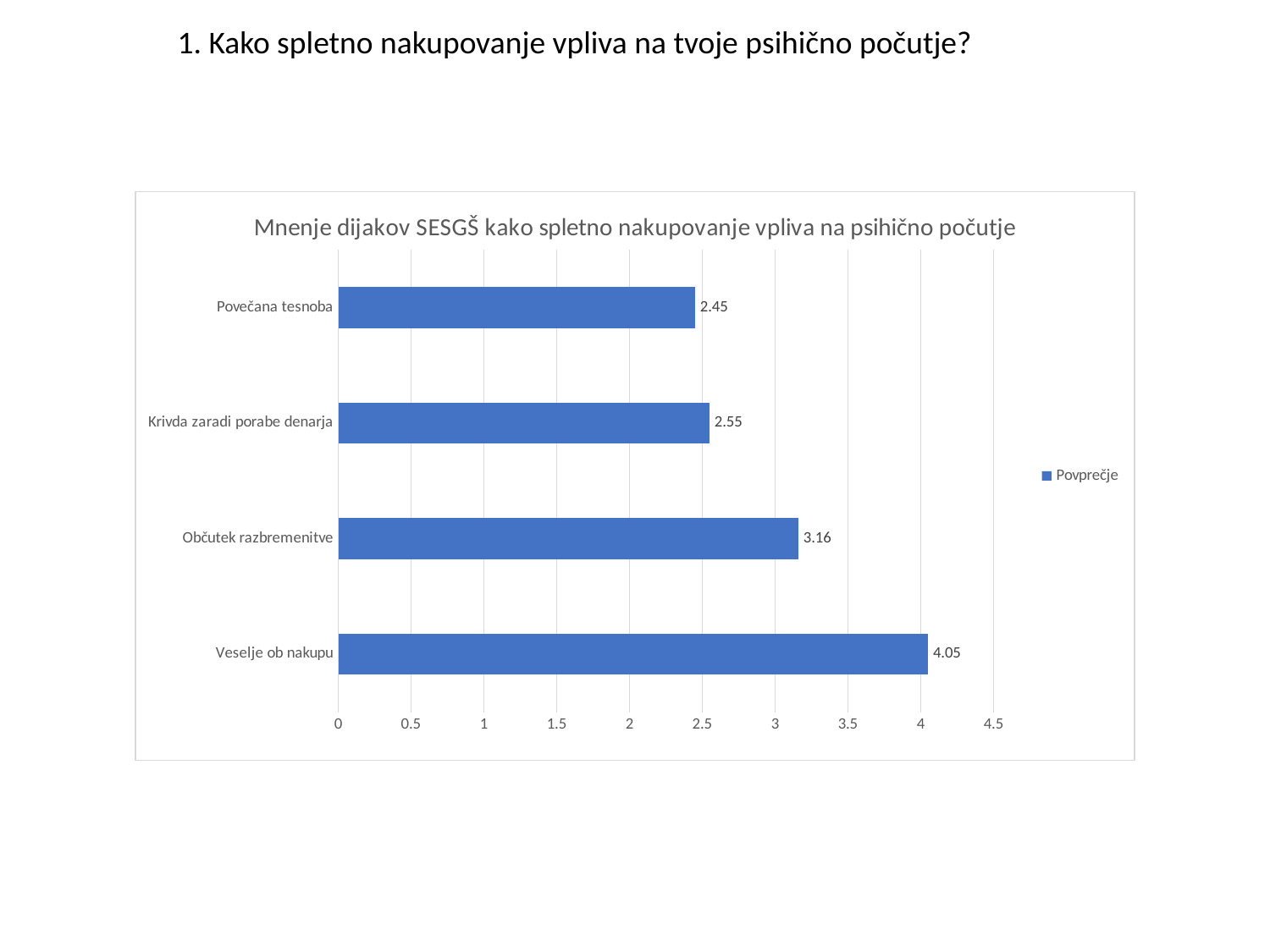
What is the value for Krivda zaradi porabe denarja? 2.55 How many categories are shown in the chart? 4 What is the value for Veselje ob nakupu? 4.05 What is the difference between the values for Krivda zaradi porabe denarja and Povečana tesnoba? 0.1 What series name does the legend list? Povprečje What is the difference between the values for Veselje ob nakupu and Občutek razbremenitve? 0.89 Which is larger, the value for Občutek razbremenitve or the value for Krivda zaradi porabe denarja? Občutek razbremenitve What kind of chart is shown on the slide? Bar chart Which category has the highest value? Veselje ob nakupu What is the value for Občutek razbremenitve? 3.16 Which category has the lowest value? Povečana tesnoba What is the value for Povečana tesnoba? 2.45